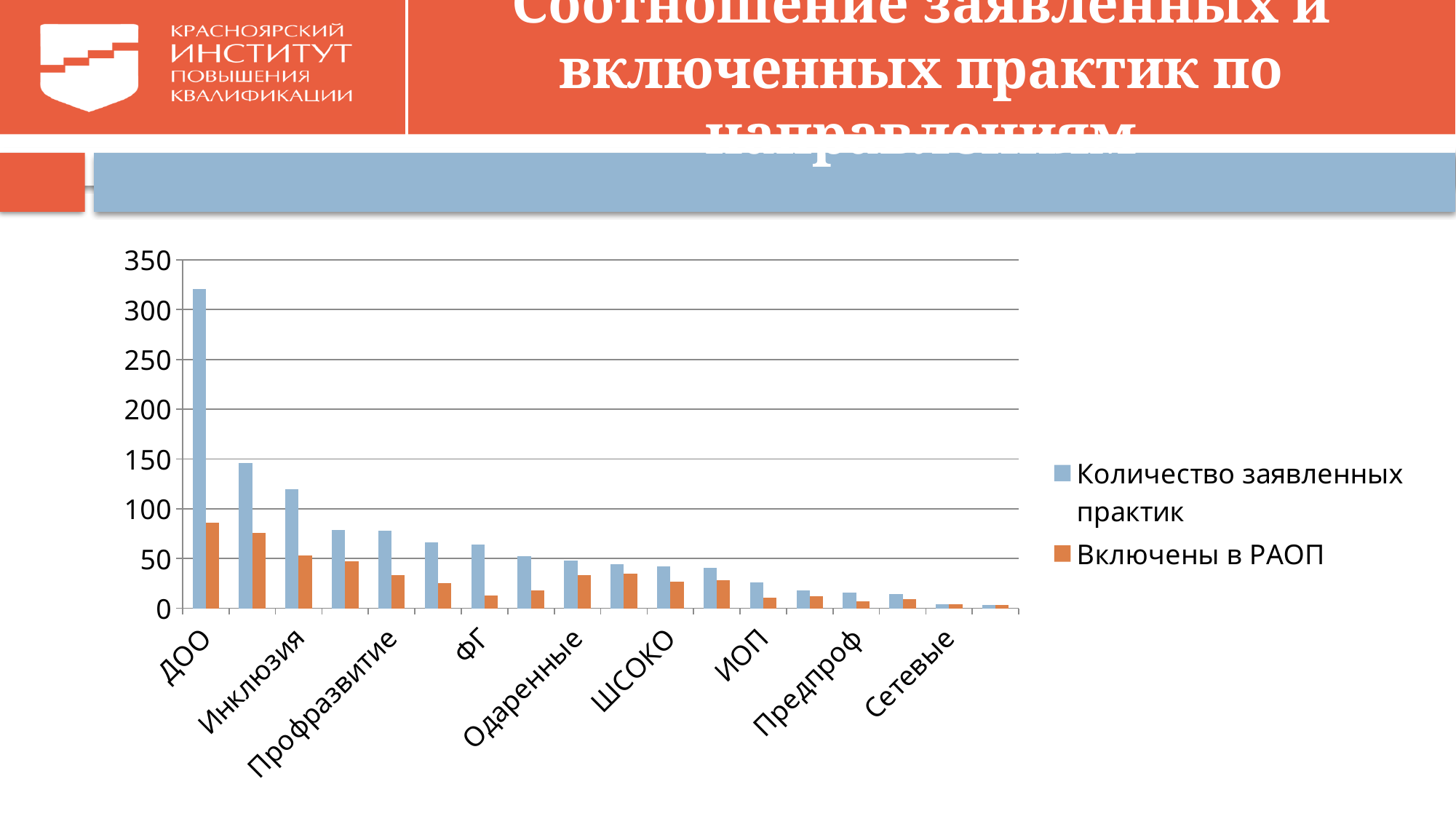
Is the value of "Включены в РАОП" for ФГ greater or less than 50? less Is the value of "Количество заявленных практик" for Инклюзия greater or less than 100? greater Is the value of "Количество заявленных практик" for ДОО greater or less than 300? greater Which is larger: "Количество заявленных практик" for ДОО or for Инклюзия? ДОО Which category has the highest value for "Включены в РАОП"? ДОО Do the values of "Количество заявленных практик" rise or fall from left to right along the x axis? fall What colour are the bars for "Включены в РАОП"? orange How many series does the legend list? 2 Which category has the highest value for "Количество заявленных практик"? ДОО What kind of chart is shown on the slide? bar chart